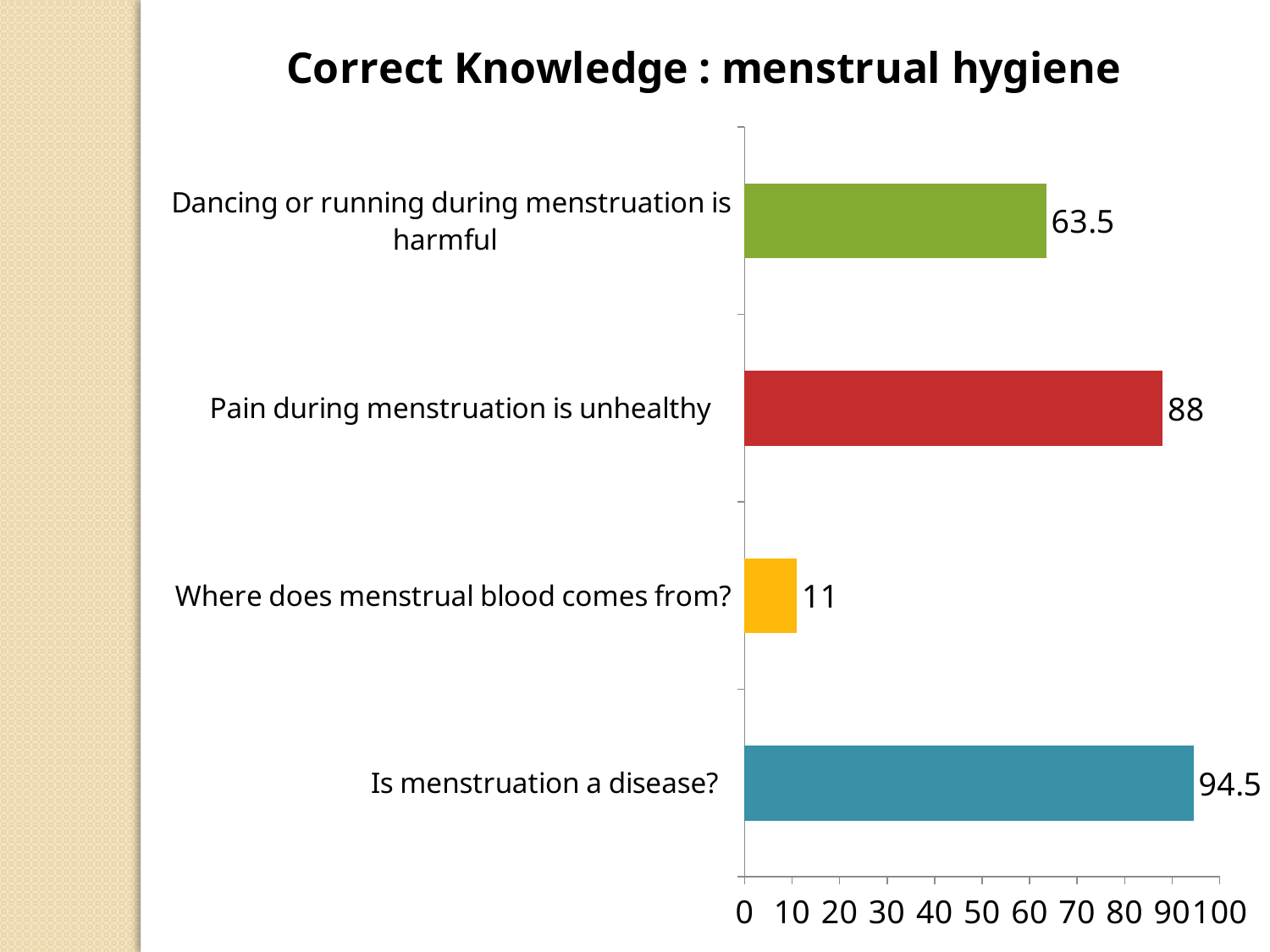
What is the difference between the values for "Pain during menstruation is unhealthy" and "Where does menstrual blood comes from?"? 77 What type of chart is shown on the slide? bar chart What is the value for "Is menstruation a disease?"? 94.5 Which is larger: the value for "Dancing or running during menstruation is harmful" or the value for "Pain during menstruation is unhealthy"? Pain during menstruation is unhealthy What is the difference between the values for "Is menstruation a disease?" and "Pain during menstruation is unhealthy"? 6.5 Which category has the lowest value? Where does menstrual blood comes from? How many categories are shown in the chart? 4 Which category has the highest value? Is menstruation a disease? What is the value for "Pain during menstruation is unhealthy"? 88 What is the value for "Where does menstrual blood comes from?"? 11 What is the value for "Dancing or running during menstruation is harmful"? 63.5 Is the value for "Dancing or running during menstruation is harmful" greater or less than 70? less